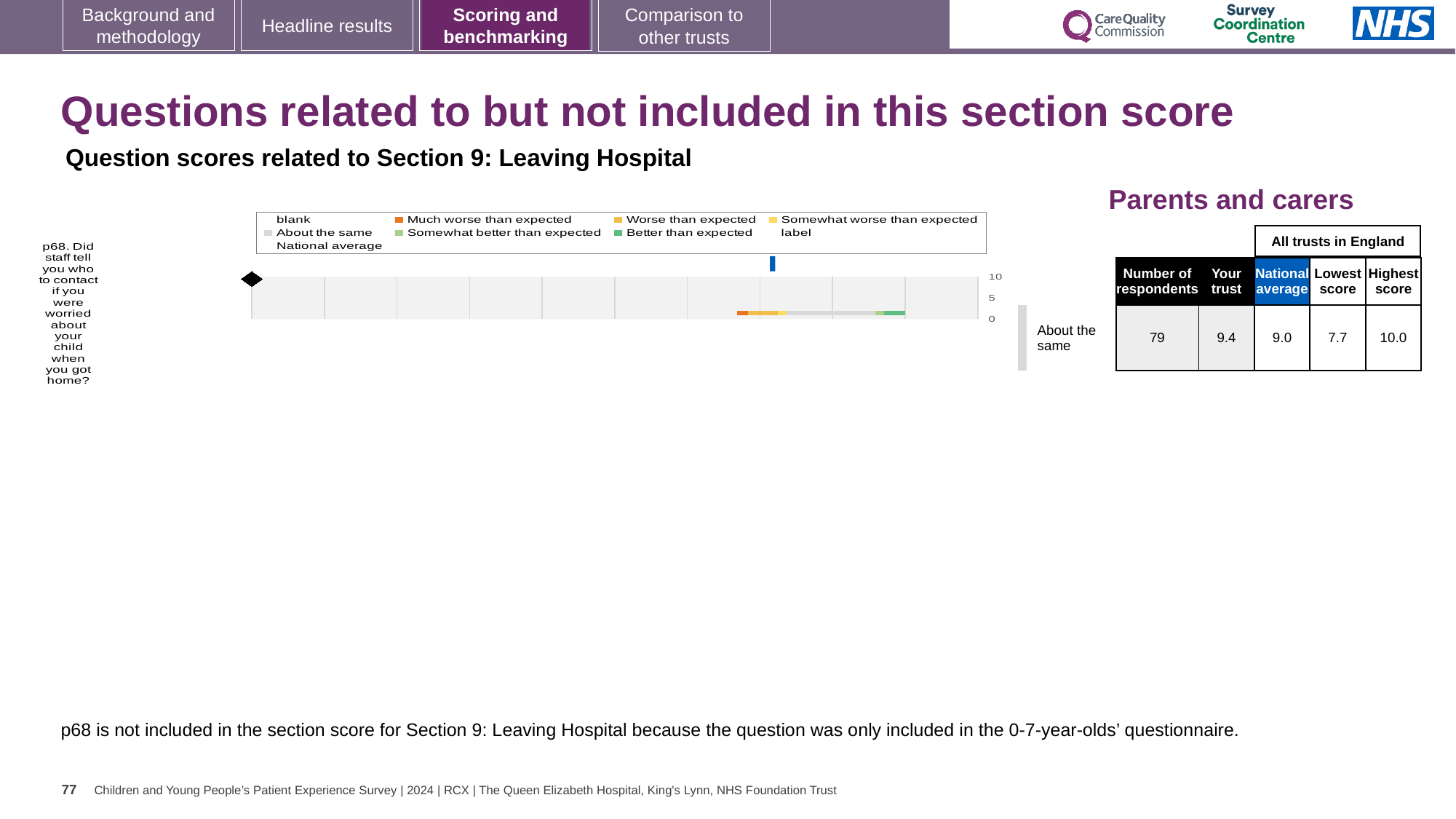
What is the Highest score among all trusts in England for p68? 10.0 How many respondents answered p68? 79 Which survey question is plotted in the chart? p68. Did staff tell you who to contact if you were worried about your child when you got home? Which is larger for p68, the 'Your trust' score or the National average? Your trust What is the highest value shown on the chart's score axis? 10 What is the Lowest score among all trusts in England for p68? 7.7 What is the difference between the 'Your trust' score and the National average for p68? 0.4 What is the National average score for p68 shown in the table? 9.0 What is the difference between the Highest score and the Lowest score for p68? 2.3 What is the 'Your trust' score for p68 shown in the table? 9.4 What kind of chart is shown on the slide? bar chart Is the 'Your trust' score for p68 greater or less than 5 on the chart axis? greater